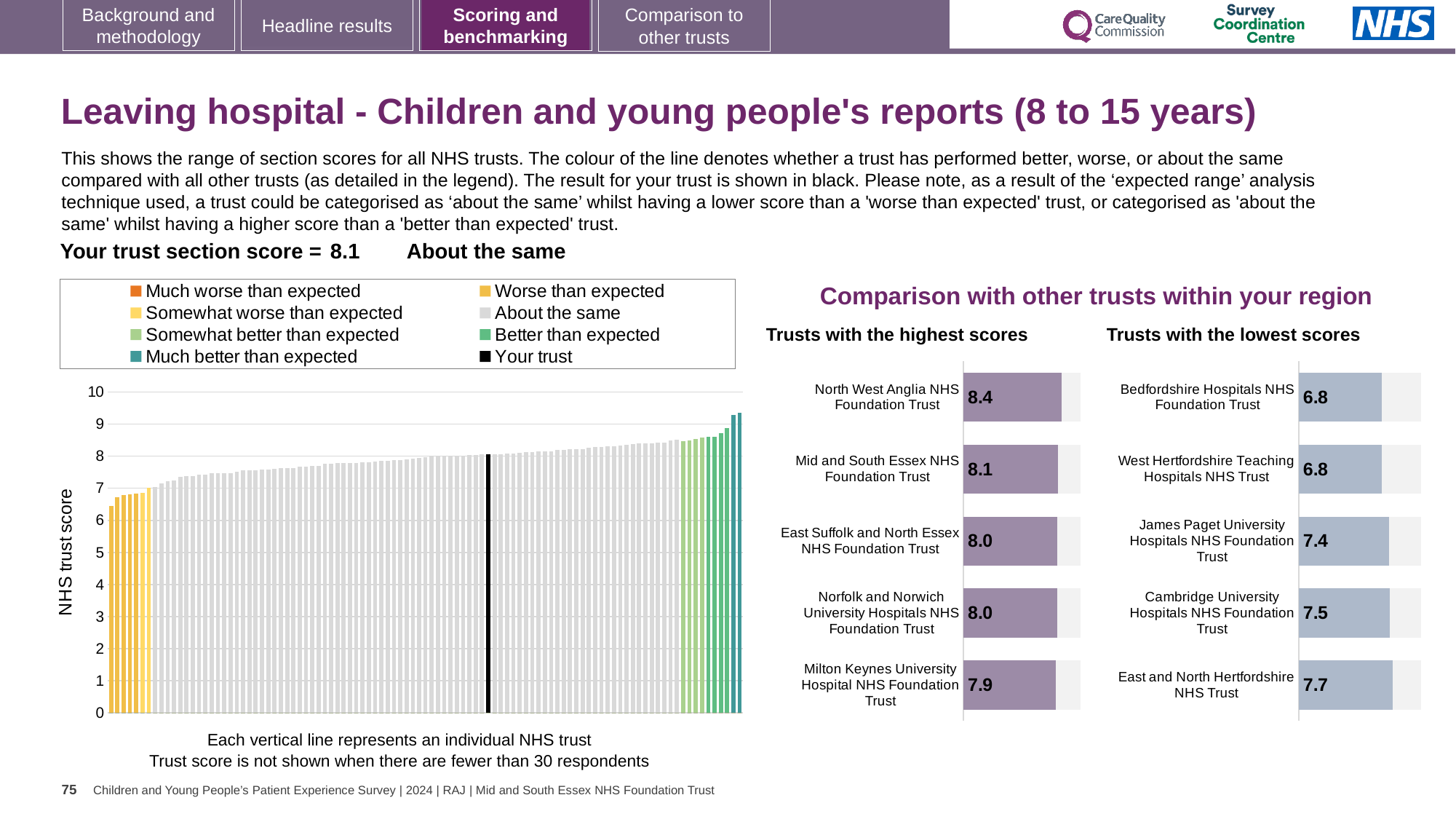
In the 'Trusts with the highest scores' chart, what is the difference between the scores of North West Anglia NHS Foundation Trust and Milton Keynes University Hospital NHS Foundation Trust? 0.5 In the 'Trusts with the highest scores' chart, what is the score for North West Anglia NHS Foundation Trust? 8.4 What kind of chart is the large chart on the left showing NHS trust scores? bar chart In the 'Trusts with the lowest scores' chart, which has the larger score: James Paget University Hospitals NHS Foundation Trust or Cambridge University Hospitals NHS Foundation Trust? Cambridge University Hospitals NHS Foundation Trust In the large chart on the left, is the value of the leftmost (lowest) bar greater or less than 7? less In the 'Trusts with the highest scores' chart, what is the score for Milton Keynes University Hospital NHS Foundation Trust? 7.9 In the 'Trusts with the lowest scores' chart, which trust has the highest score? East and North Hertfordshire NHS Trust In the large chart on the left, do the trust scores rise or fall from left to right? rise How many entries does the legend above the large chart on the left list? 8 In the 'Trusts with the lowest scores' chart, how many trusts are listed? 5 In the 'Trusts with the highest scores' chart, which trust has the lowest score? Milton Keynes University Hospital NHS Foundation Trust In the 'Trusts with the lowest scores' chart, what is the score for James Paget University Hospitals NHS Foundation Trust? 7.4